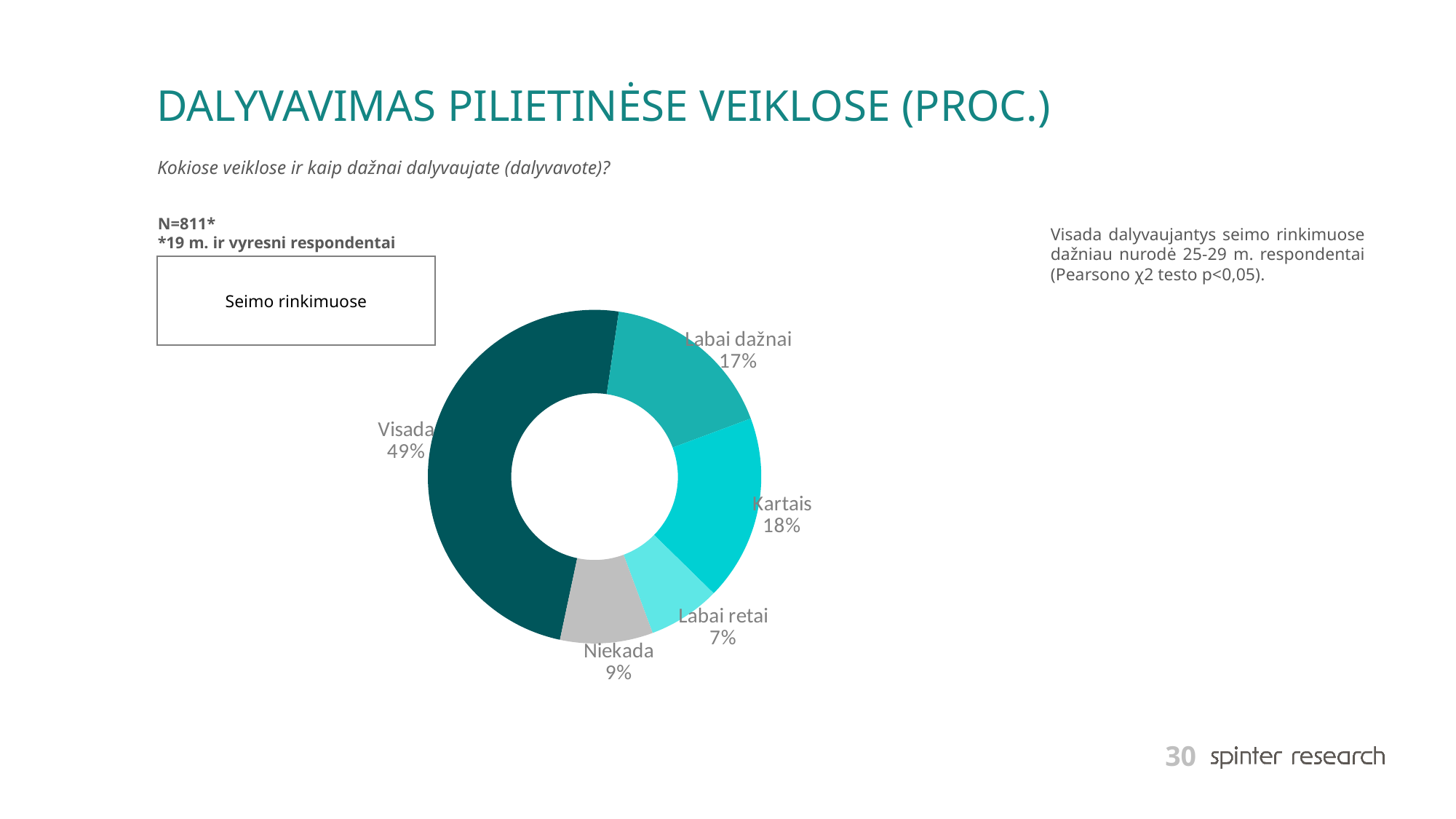
What percentage is shown for "Labai retai"? 7% What is the difference in percentage points between "Visada" and "Kartais"? 31 Which category has the largest share of the pie? Visada How many categories are shown in the chart? 5 What is the label in the box above the chart identifying the activity? Seimo rinkimuose What percentage is shown for "Labai dažnai"? 17% Which category has the smallest share of the pie? Labai retai What kind of chart is shown on the slide? Pie chart (doughnut) What share of respondents answered "Visada" for Seimo rinkimuose? 49% Which is larger, the share for "Niekada" or the share for "Labai retai"? Niekada What percentage is shown for "Kartais"? 18% What percentage is shown for "Niekada"? 9%